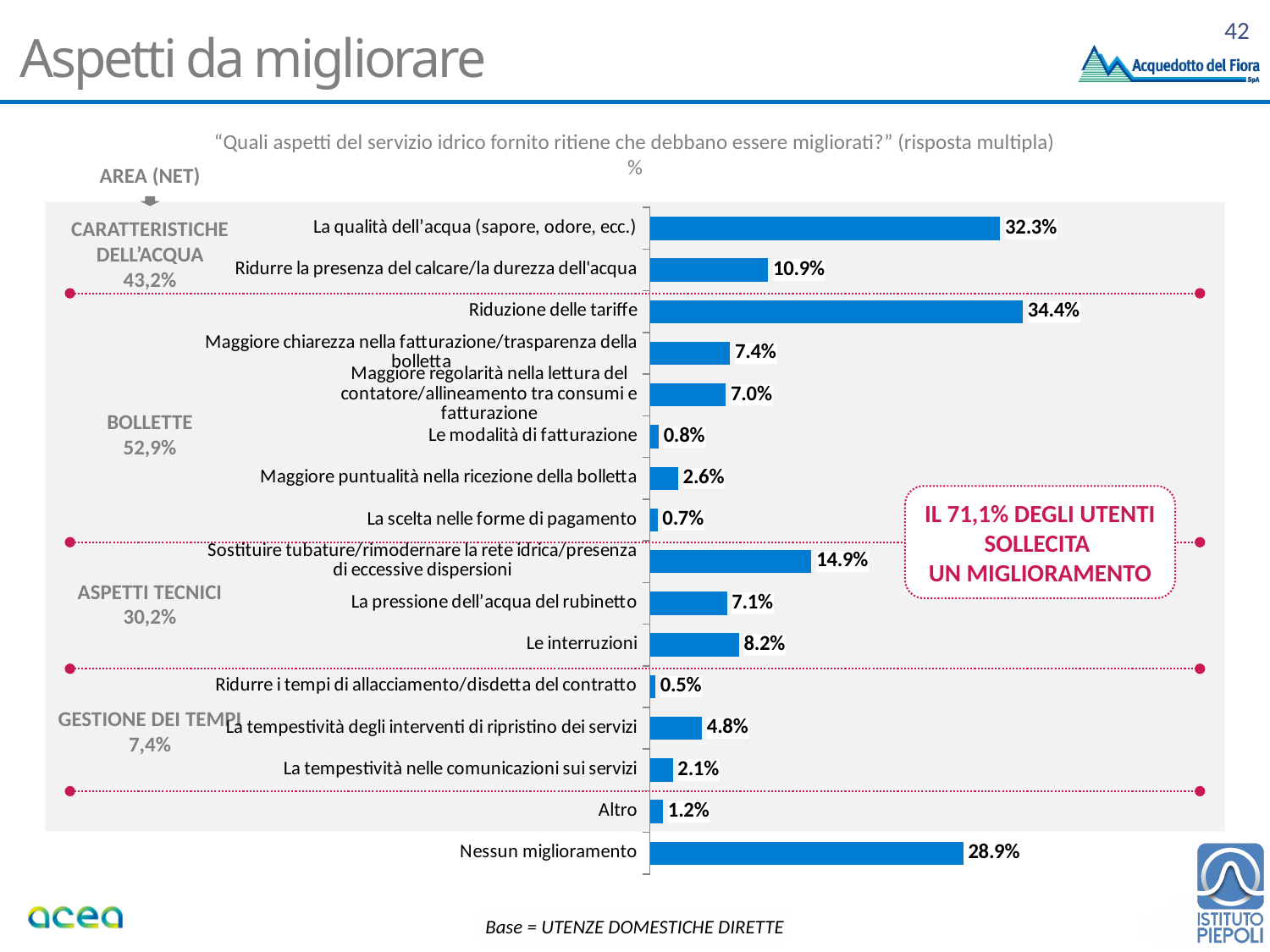
What kind of chart is shown on the slide? Bar chart What is the value for "La tempestività degli interventi di ripristino dei servizi"? 4.8% Which category has the highest value? Riduzione delle tariffe What is the value for "Le interruzioni"? 8.2% Which category has the lowest value? Ridurre i tempi di allacciamento/disdetta del contratto What is the NET value shown for the "BOLLETTE" area? 52,9% What is the value for "Riduzione delle tariffe"? 34.4% What is the value for "Nessun miglioramento"? 28.9% What percentage of users is stated in the callout box as requesting an improvement? 71,1% What is the difference between "Riduzione delle tariffe" and "La qualità dell'acqua (sapore, odore, ecc.)"? 2.1% How many categories are plotted in the chart? 16 Which is larger: "Le interruzioni" or "La pressione dell'acqua del rubinetto"? Le interruzioni